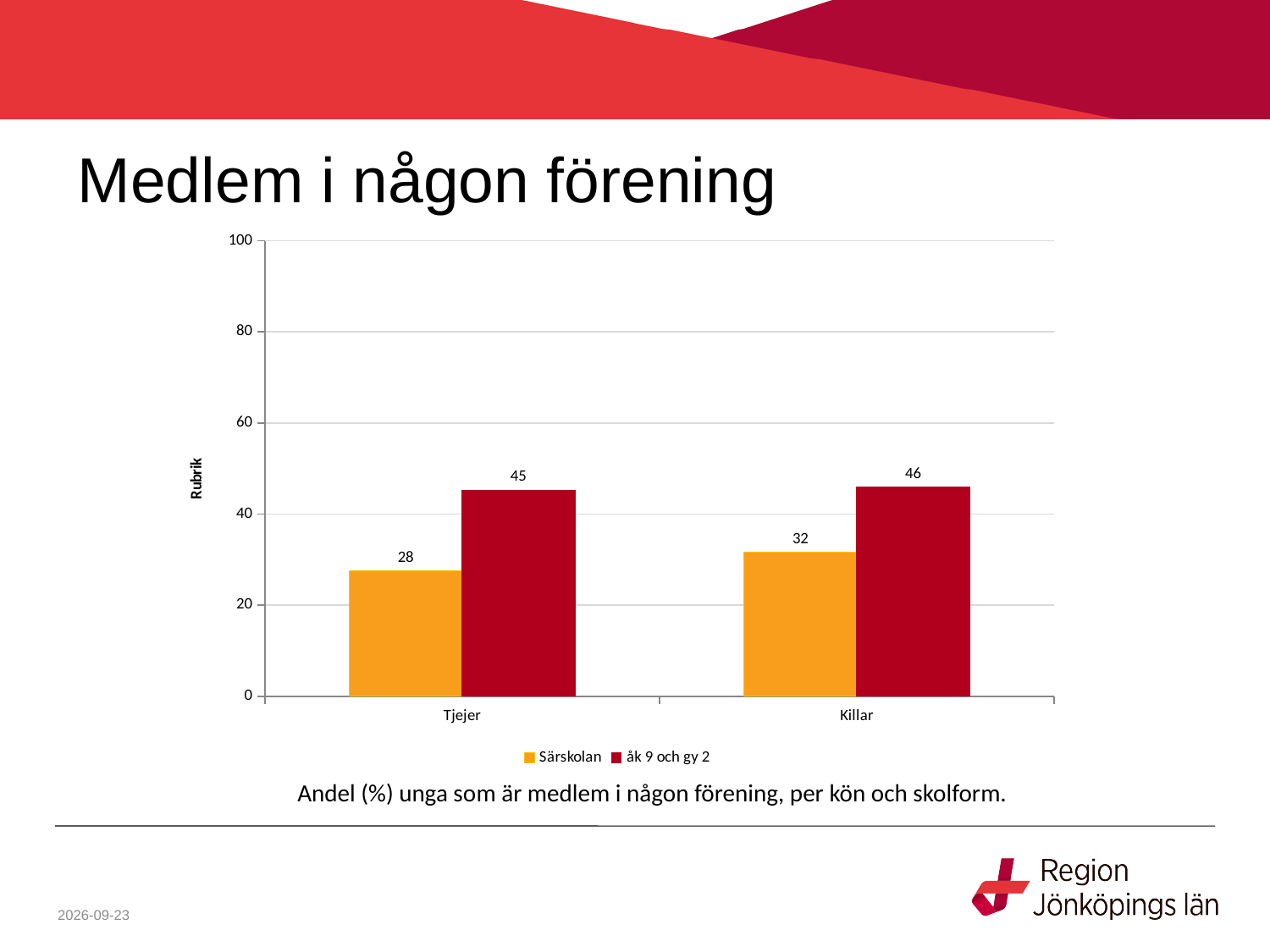
Which series has the lowest value in the Tjejer category? Särskolan Which category has the highest value for Särskolan? Killar What is the value for åk 9 och gy 2 in the Tjejer category? 45 What is the value for Särskolan in the Tjejer category? 28 What is the value for åk 9 och gy 2 in the Killar category? 46 How many series does the legend list? 2 What is the difference between the åk 9 och gy 2 value and the Särskolan value for Tjejer? 17 How many categories are shown on the x axis? 2 What kind of chart is shown on the slide? Bar chart What is the value for Särskolan in the Killar category? 32 Which is larger for Killar: Särskolan or åk 9 och gy 2? åk 9 och gy 2 What is the difference between the Särskolan values for Killar and Tjejer? 4